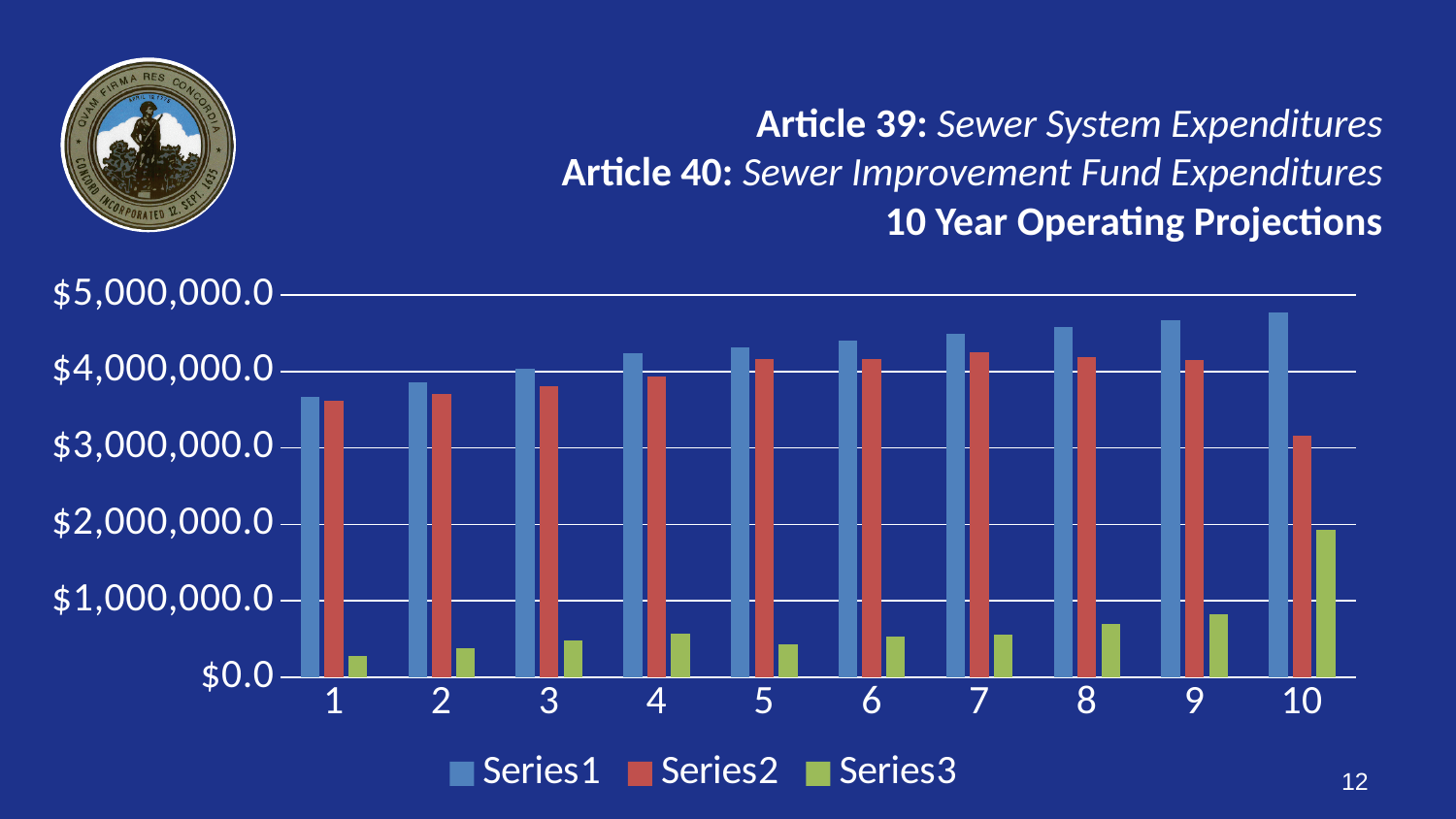
Which category has the highest Series1 value? 10 Is the Series1 value for category 1 greater or less than $4,000,000.0? less How many categories are shown along the x axis? 10 How many series does the legend list? 3 What kind of chart is shown on the slide? bar chart Is the Series3 value for category 10 greater or less than $1,000,000.0? greater What are the three legend entries of the chart? Series1, Series2, Series3 Which category has the lowest Series2 value? 10 Is the Series1 value for category 10 greater or less than $4,000,000.0? greater In category 10, which is larger, Series1 or Series2? Series1 Which category has the lowest Series3 value? 1 Do the Series1 values rise or fall from category 1 to category 10? rise